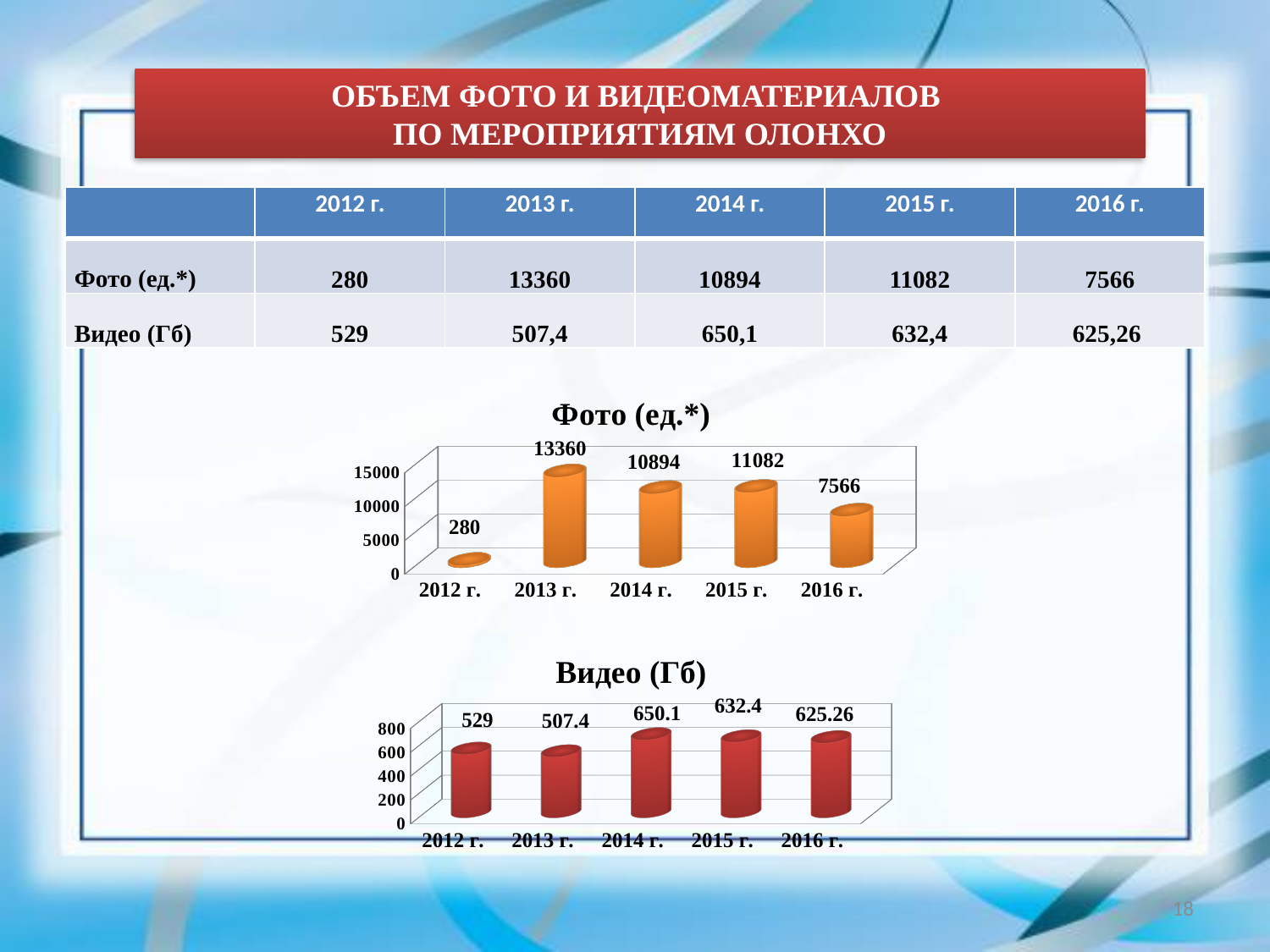
In the "Фото (ед.*)" chart, which is larger, the value for 2014 г. or 2015 г.? 2015 г. In the "Фото (ед.*)" chart, which year has the highest value? 2013 г. In the "Видео (Гб)" chart, what is the difference between the values for 2014 г. and 2012 г.? 121.1 In the "Видео (Гб)" chart, which year has the lowest value? 2013 г. What colour are the bars in the "Видео (Гб)" chart? Red In the "Видео (Гб)" chart, which year has the highest value? 2014 г. What kind of chart is the "Фото (ед.*)" chart? Bar chart In the "Фото (ед.*)" chart, what is the value for 2013 г.? 13360 In the "Фото (ед.*)" chart, what is the difference between the values for 2013 г. and 2016 г.? 5794 In the "Фото (ед.*)" chart, which year has the lowest value? 2012 г. How many years are shown on the x axis of the "Видео (Гб)" chart? 5 In the "Видео (Гб)" chart, what is the value for 2016 г.? 625.26